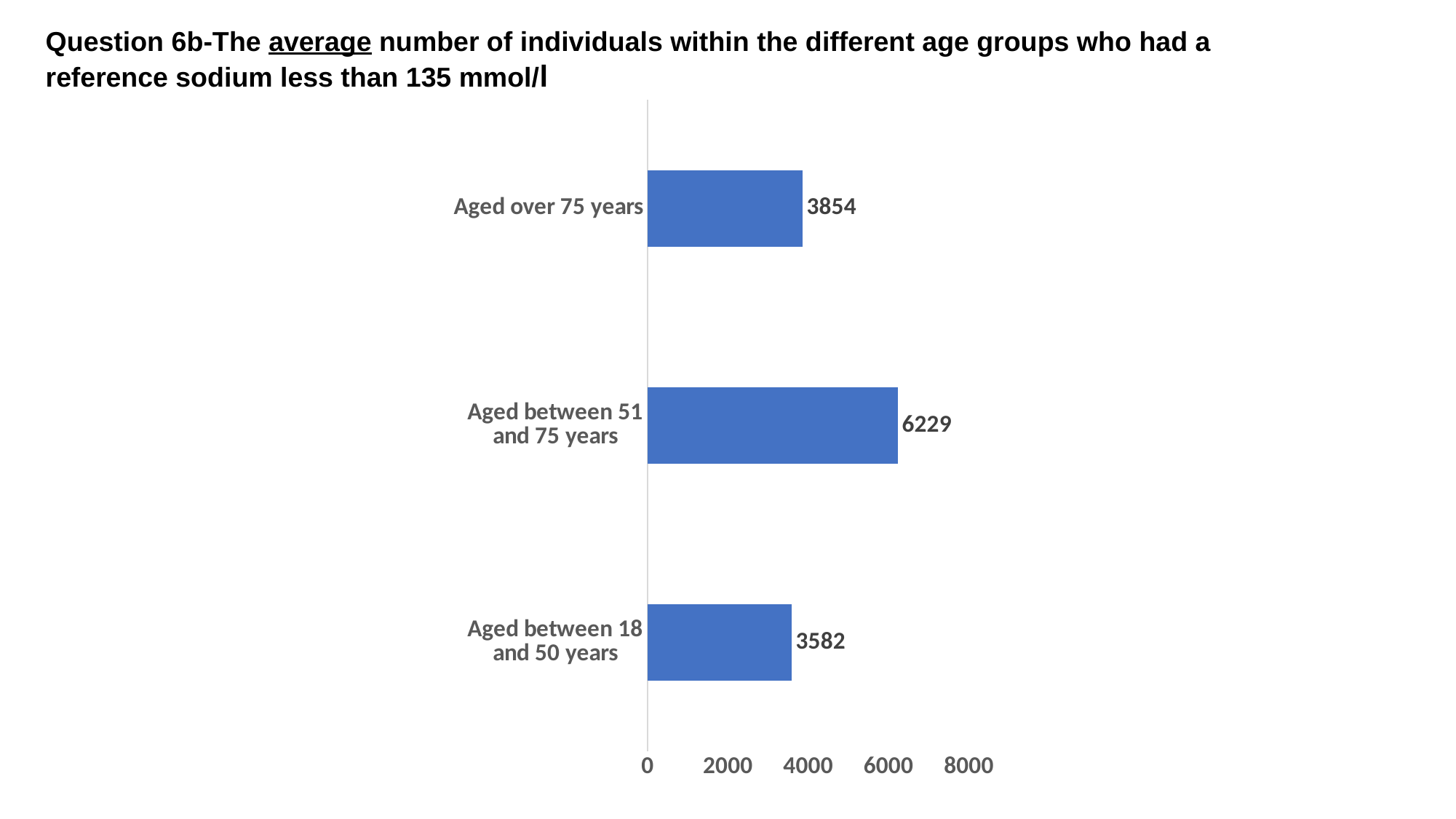
What is the difference between the values for Aged over 75 years and Aged between 18 and 50 years? 272 What is the difference between the values for Aged between 51 and 75 years and Aged over 75 years? 2375 Which is larger, the value for Aged over 75 years or the value for Aged between 18 and 50 years? Aged over 75 years What is the value for Aged between 51 and 75 years? 6229 What is the value for Aged over 75 years? 3854 Is the value for Aged between 51 and 75 years greater or less than 6000? greater What is the value for Aged between 18 and 50 years? 3582 Which age group has the highest value? Aged between 51 and 75 years What kind of chart is shown on the slide? bar chart What is the highest value shown on the horizontal axis? 8000 Which age group has the lowest value? Aged between 18 and 50 years How many age groups are shown in the chart? 3